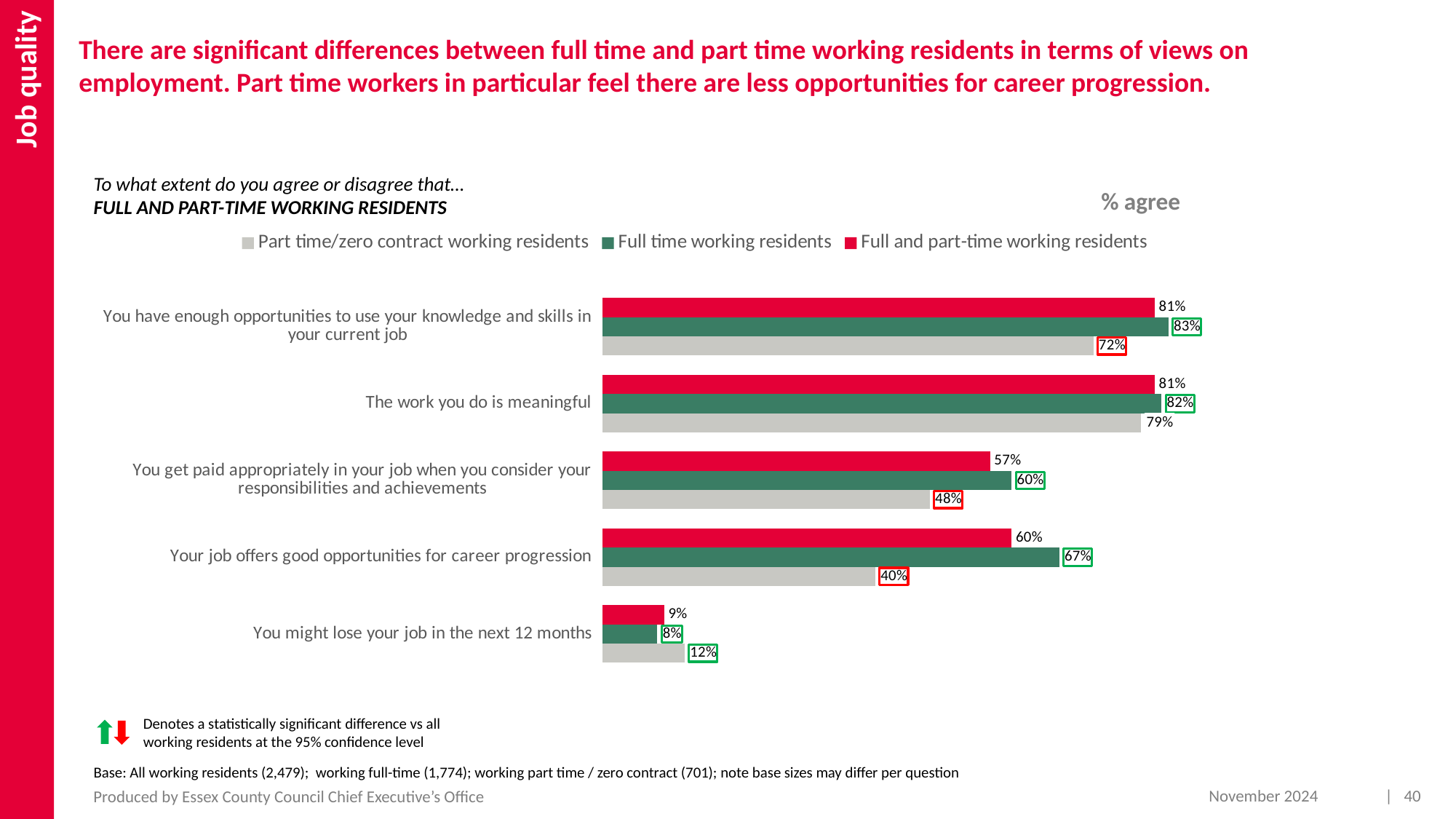
What percentage of full time working residents agree that they have enough opportunities to use their knowledge and skills in their current job? 83% Which statement has the highest % agree among part time/zero contract working residents? The work you do is meaningful What type of chart is shown on the slide? Bar chart What percentage of part time/zero contract working residents agree that their job offers good opportunities for career progression? 40% What percentage of full and part-time working residents agree that they get paid appropriately in their job? 57% How many series does the legend list? 3 Which colour represents part time/zero contract working residents in the chart? Grey How many statements are shown on the chart? 5 What percentage of part time/zero contract working residents agree that they might lose their job in the next 12 months? 12% For 'You might lose your job in the next 12 months', which group has the higher % agree: full time working residents or part time/zero contract working residents? Part time/zero contract working residents Which statement has the lowest % agree among full time working residents? You might lose your job in the next 12 months What is the difference in % agree between full time and part time/zero contract working residents for 'Your job offers good opportunities for career progression'? 27 percentage points